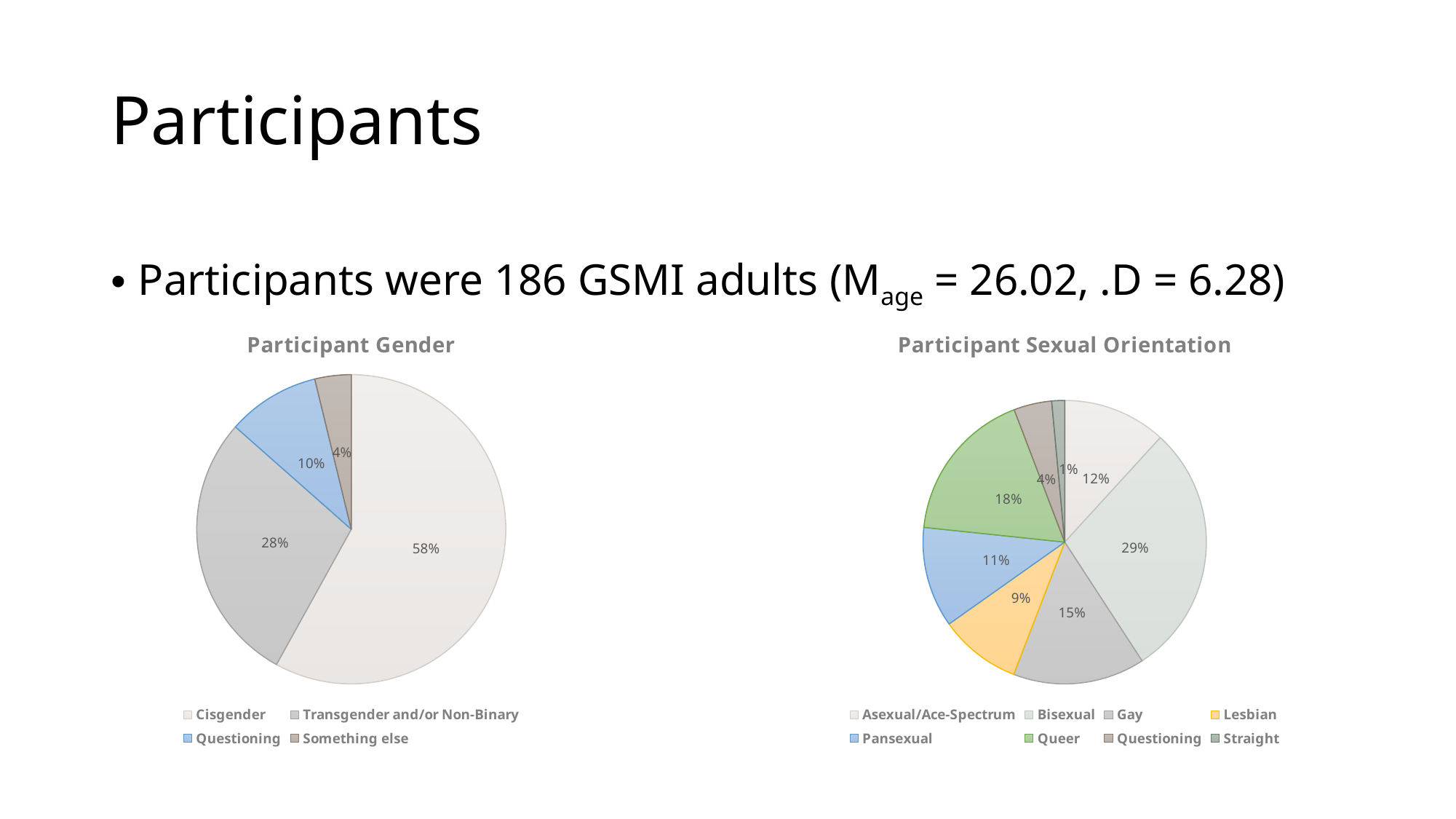
In the Participant Sexual Orientation chart, which category has the smallest share? Straight In the Participant Sexual Orientation chart, what percentage of participants are Bisexual? 29% How many categories does the Participant Sexual Orientation chart show? 8 In the Participant Gender chart, what percentage of participants are Transgender and/or Non-Binary? 28% In the Participant Sexual Orientation chart, what percentage of participants are Queer? 18% In the Participant Gender chart, what is the difference between the Cisgender and Transgender and/or Non-Binary shares? 30% In the Participant Sexual Orientation chart, which is larger, the Pansexual share or the Lesbian share? Pansexual What type of chart is the Participant Sexual Orientation chart? Pie chart In the Participant Gender chart, what percentage of participants are Cisgender? 58% In the Participant Gender chart, which category has the smallest share? Something else How many categories does the Participant Gender chart show? 4 In the Participant Sexual Orientation chart, which category has the largest share? Bisexual